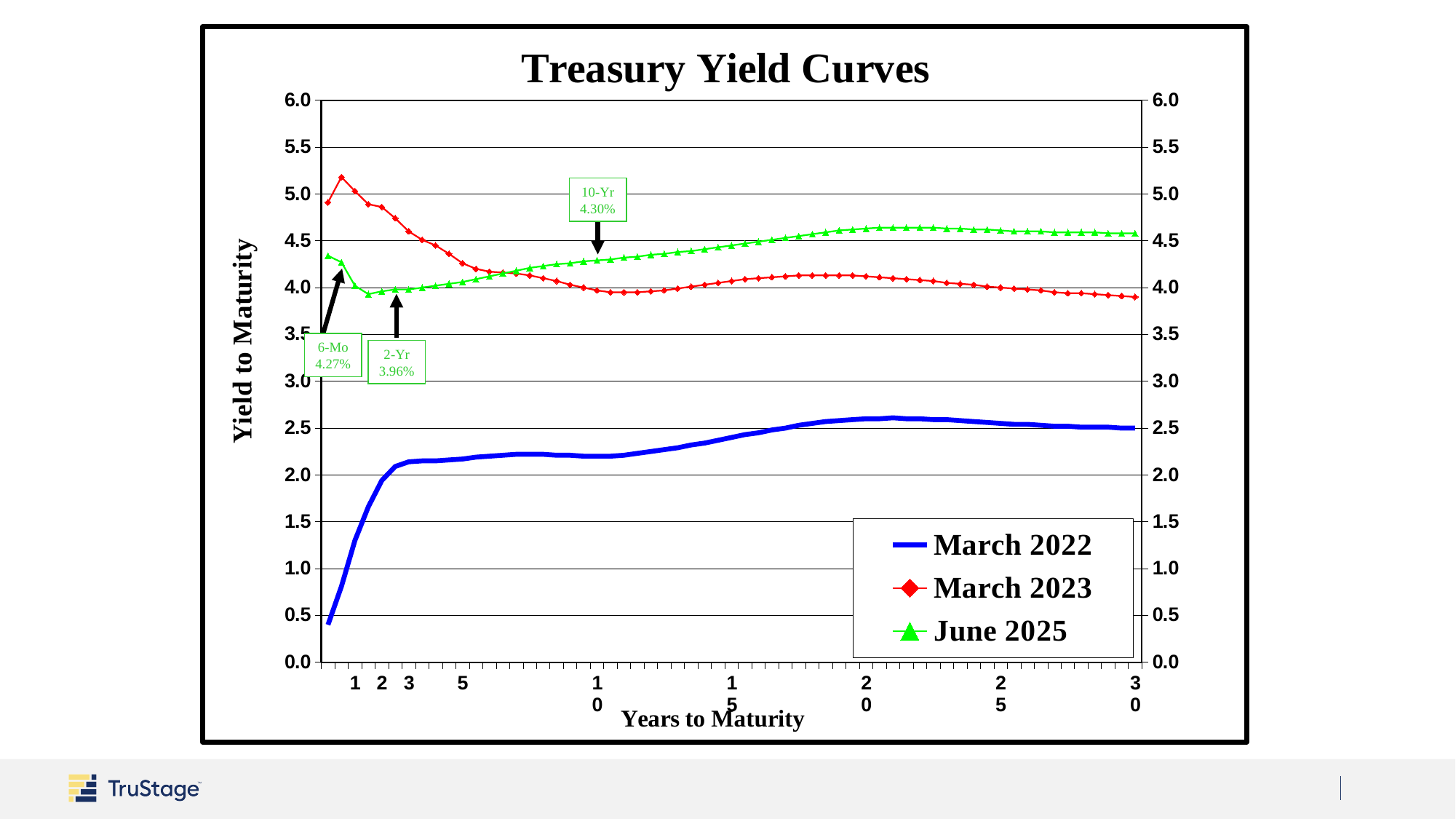
What is the 2-Yr yield annotated for the June 2025 curve? 3.96% By how much does the annotated June 2025 10-Yr yield exceed the annotated 2-Yr yield? 0.34% Is the March 2022 yield at 30 years to maturity greater or less than 3.0? less At 30 years to maturity, which series has the higher yield: March 2023 or June 2025? June 2025 Which series has the lowest yields across the whole range of maturities? March 2022 Is the March 2023 yield at 1 year to maturity greater or less than 4.5? greater What is the 10-Yr yield annotated for the June 2025 curve? 4.30% What is the 6-Mo yield annotated for the June 2025 curve? 4.27% What is the title of the chart? Treasury Yield Curves How many series does the legend list? 3 What is the label on the vertical axis? Yield to Maturity What kind of chart is shown on the slide? line chart